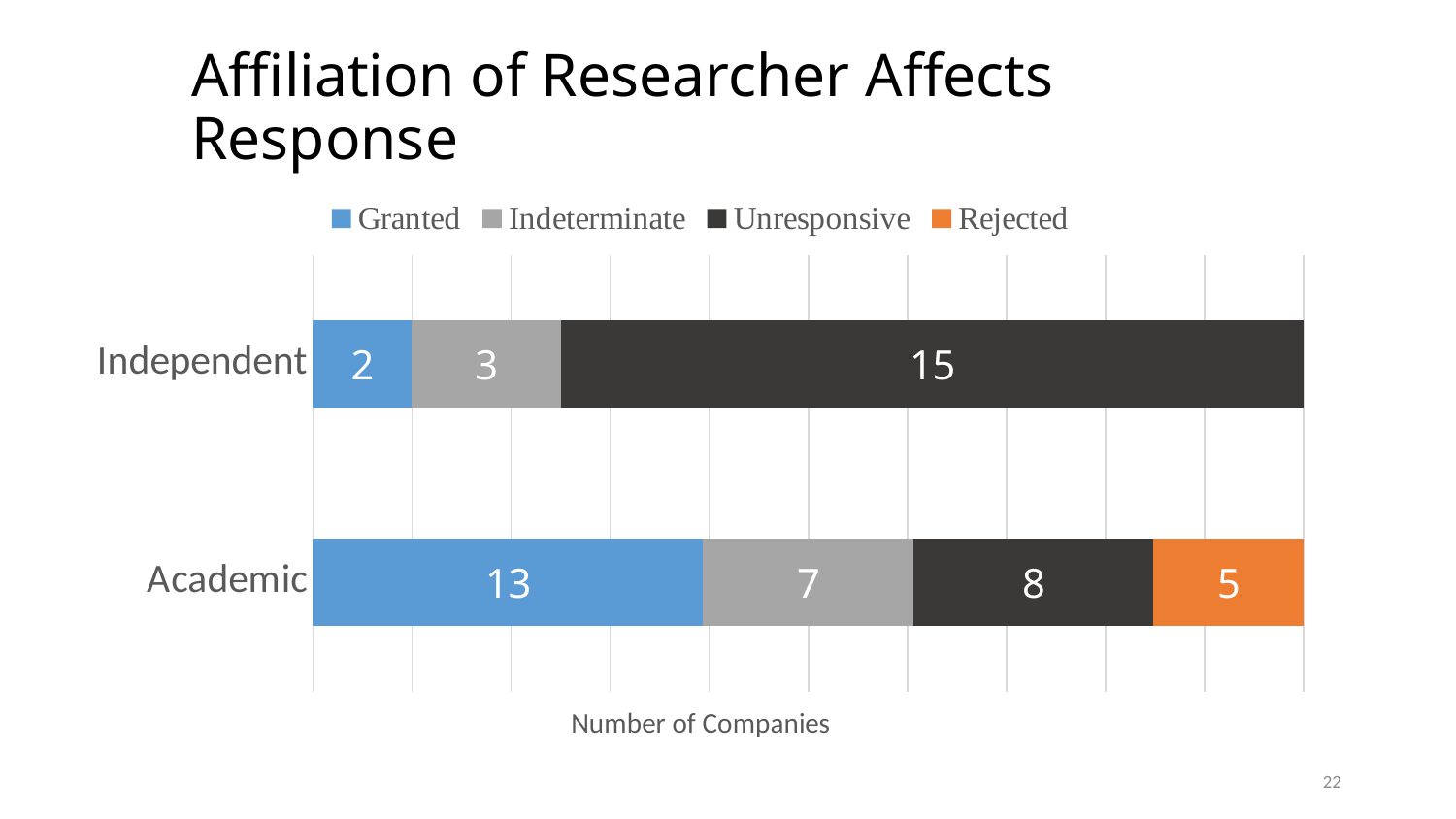
What is the Rejected value for Academic researchers? 5 How many researcher affiliation categories are shown on the chart? 2 Which response category has the largest value in the Independent bar? Unresponsive Which response category has the smallest value in the Academic bar? Rejected How many companies granted access to Academic researchers? 13 What is the Unresponsive value for Independent researchers? 15 What is the Indeterminate value for Independent researchers? 3 What kind of chart is shown on the slide? Stacked bar chart How many series does the legend list? 4 Which group has the larger Unresponsive value, Independent or Academic? Independent What is the total number of companies in the Academic bar? 33 How many more companies granted access to Academic researchers than to Independent researchers? 11